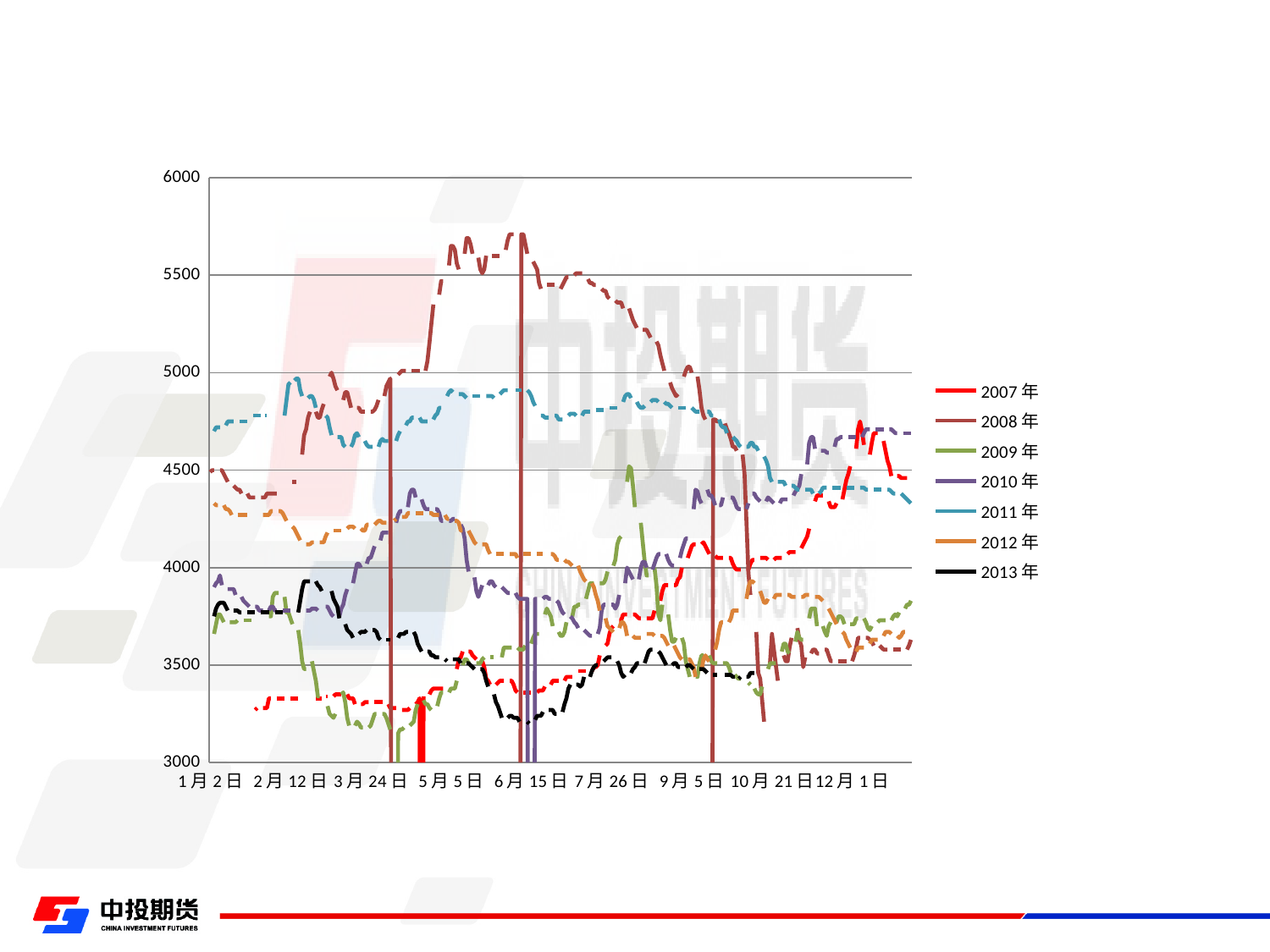
What kind of chart is shown on the slide? line chart Does the 2008年 line rise or fall between 6月15日 and 10月21日? fall Is the value of the 2009年 line at 3月24日 greater or less than 3500? less Is the value of the 2011年 line at 6月15日 greater or less than 4500? greater How many date labels are shown on the x axis? 9 At 5月5日, which line is higher: 2008年 or 2009年? 2008年 How many series does the legend list? 7 At 1月2日, which line is higher: 2011年 or 2013年? 2011年 Is the value of the 2008年 line at 5月5日 greater or less than 5500? greater Which series reaches the highest value on the chart? 2008年 What colour is the 2013年 line in the legend? black